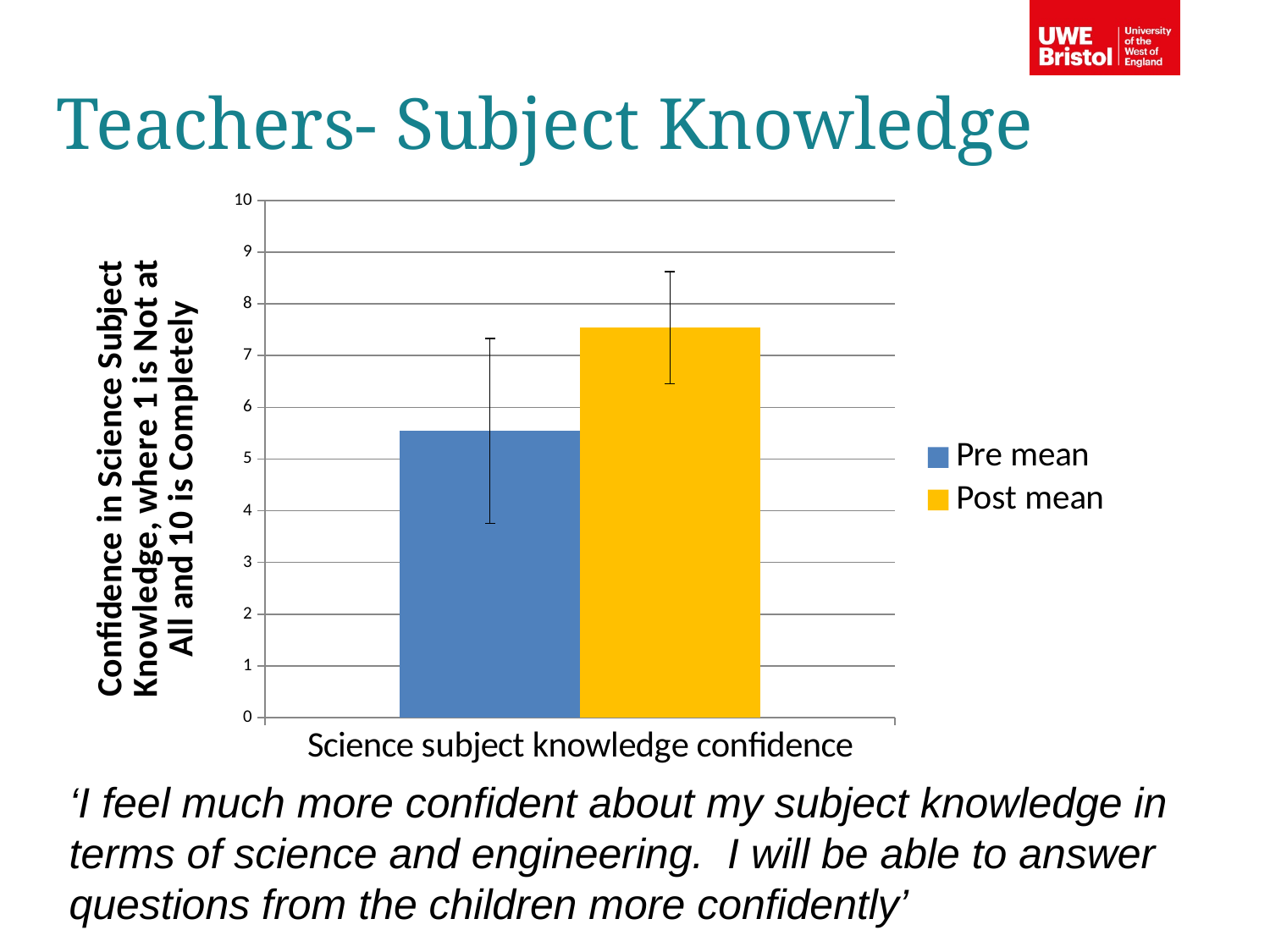
What colour is the Post mean bar? yellow How many categories are plotted on the x axis? 1 What kind of chart is shown on the slide? bar chart What is the category label shown on the x axis? Science subject knowledge confidence Is the value for Post mean greater or less than 8? less Which series has the lowest bar? Pre mean Which series has the highest bar? Post mean Is the value for Post mean greater or less than 7? greater Which series has the higher value: Pre mean or Post mean? Post mean Is the value for Pre mean greater or less than 5? greater How many series does the legend list? 2